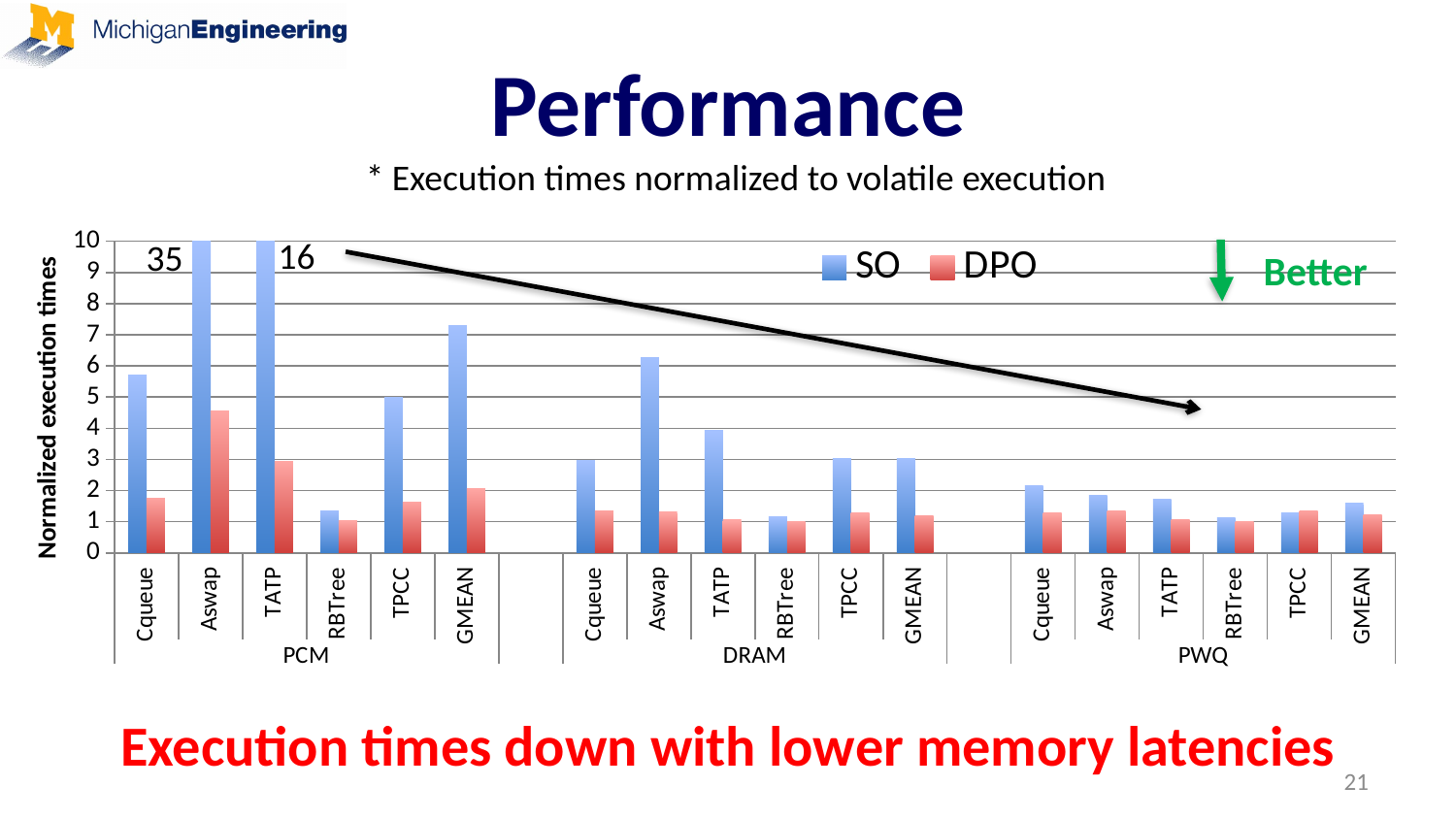
What kind of chart is shown on the slide? bar chart Is the SO value for Aswap in the DRAM group greater or less than 6? greater How many series does the legend list? 2 Which is larger for GMEAN: the SO value in the PCM group or the SO value in the PWQ group? PCM Does the SO value for GMEAN rise or fall going from PCM to DRAM to PWQ? fall What is the SO value for Aswap in the PCM group, as annotated on the chart? 35 Which benchmark has the highest SO value in the PCM group? Aswap How many memory-type groups (PCM, DRAM, PWQ) are shown on the x axis? 3 What are the two series named in the legend? SO and DPO What is the SO value for TATP in the PCM group, as annotated on the chart? 16 Is the SO value for GMEAN in the PCM group greater or less than 7? greater How many benchmark categories are plotted in total across all three groups? 18